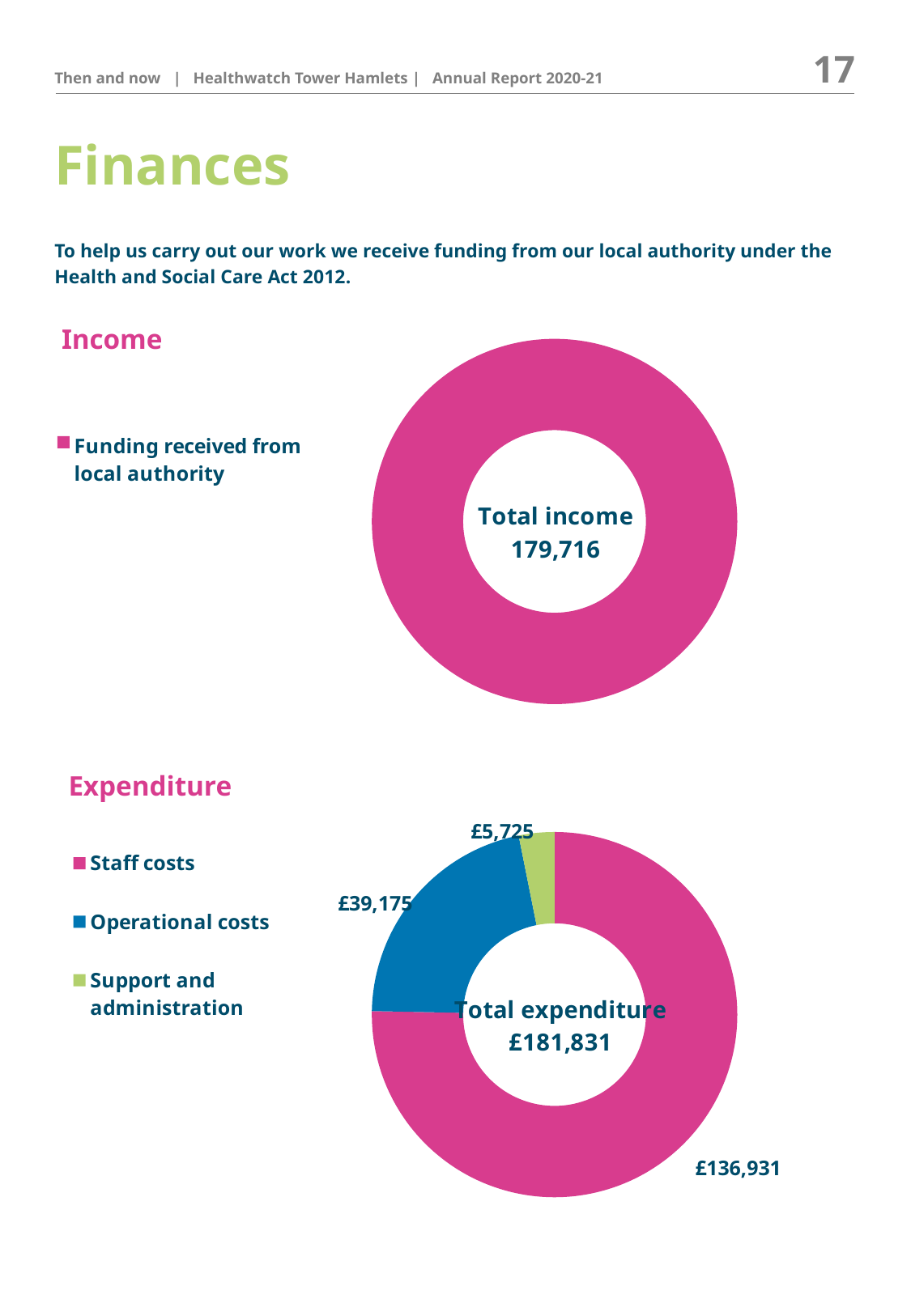
In the Expenditure chart, what is the value for Operational costs? £39,175 How many categories does the Expenditure chart's legend list? 3 What kind of chart is the Income chart? Donut (pie) chart In the Expenditure chart, what is the difference between Staff costs and Operational costs? £97,756 In the Expenditure chart, what is the value for Support and administration? £5,725 In the Income chart, what is the total income shown in the centre? 179,716 In the Expenditure chart, what is the total expenditure shown in the centre? £181,831 In the Income chart, what is the only legend entry? Funding received from local authority In the Expenditure chart, which category has the highest value? Staff costs In the Expenditure chart, which is larger, Operational costs or Support and administration? Operational costs In the Expenditure chart, what is the value for Staff costs? £136,931 In the Expenditure chart, which category has the lowest value? Support and administration